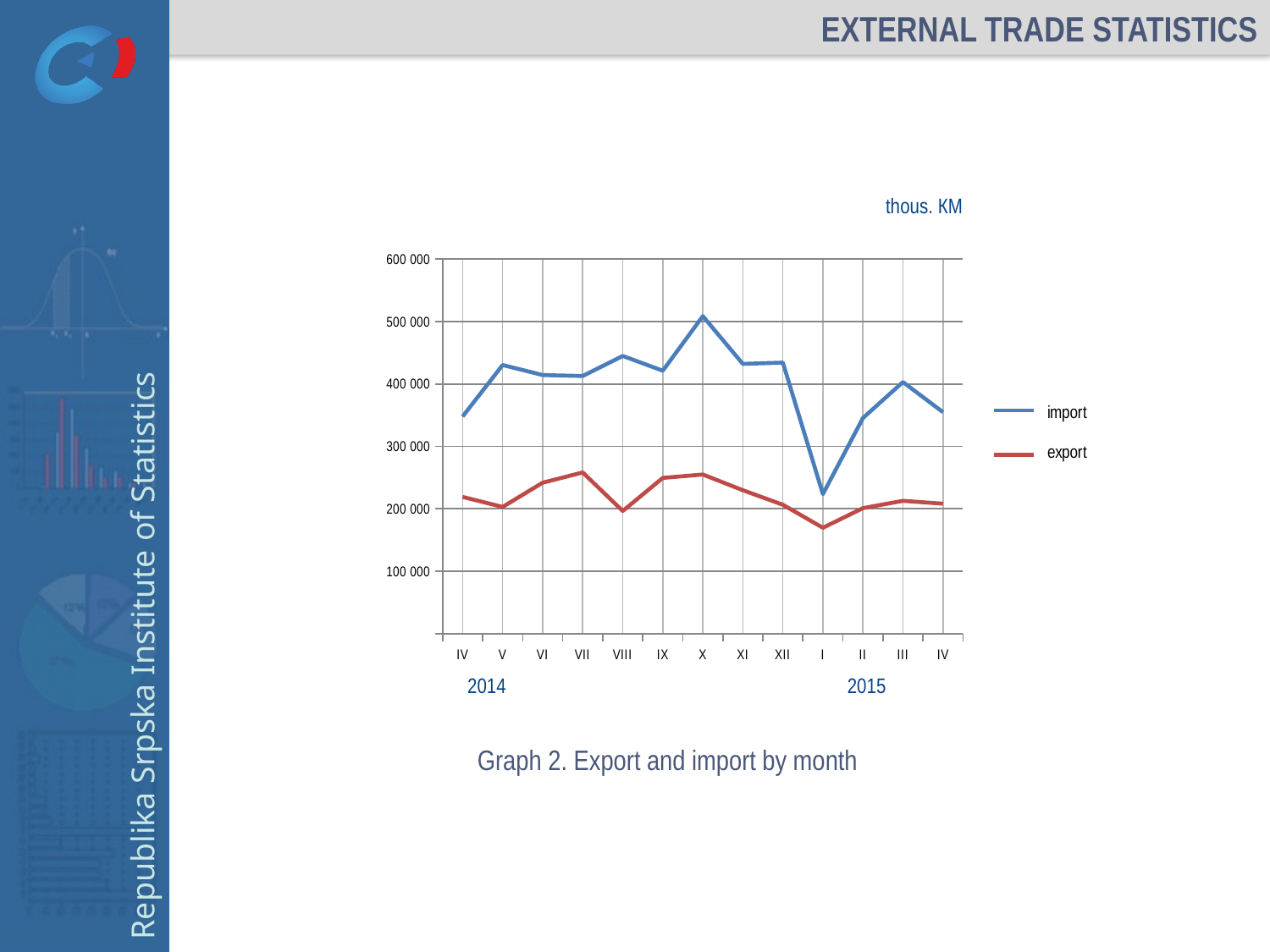
Is the import value for I 2015 greater or less than 300 000? less Is the export value for VII 2014 greater or less than 200 000? greater How many series does the legend list? 2 In which month is the export value lowest? I 2015 Does the import value rise or fall from X 2014 to XII 2014? fall In which month is the import value highest? X 2014 How many monthly points are plotted along the x axis? 13 Which is larger in X 2014, import or export? import What unit is stated above the chart? thous. KM Is the import value for IV 2014 greater or less than 400 000? less In which month is the import value lowest? I 2015 What kind of chart is shown on the slide? line chart